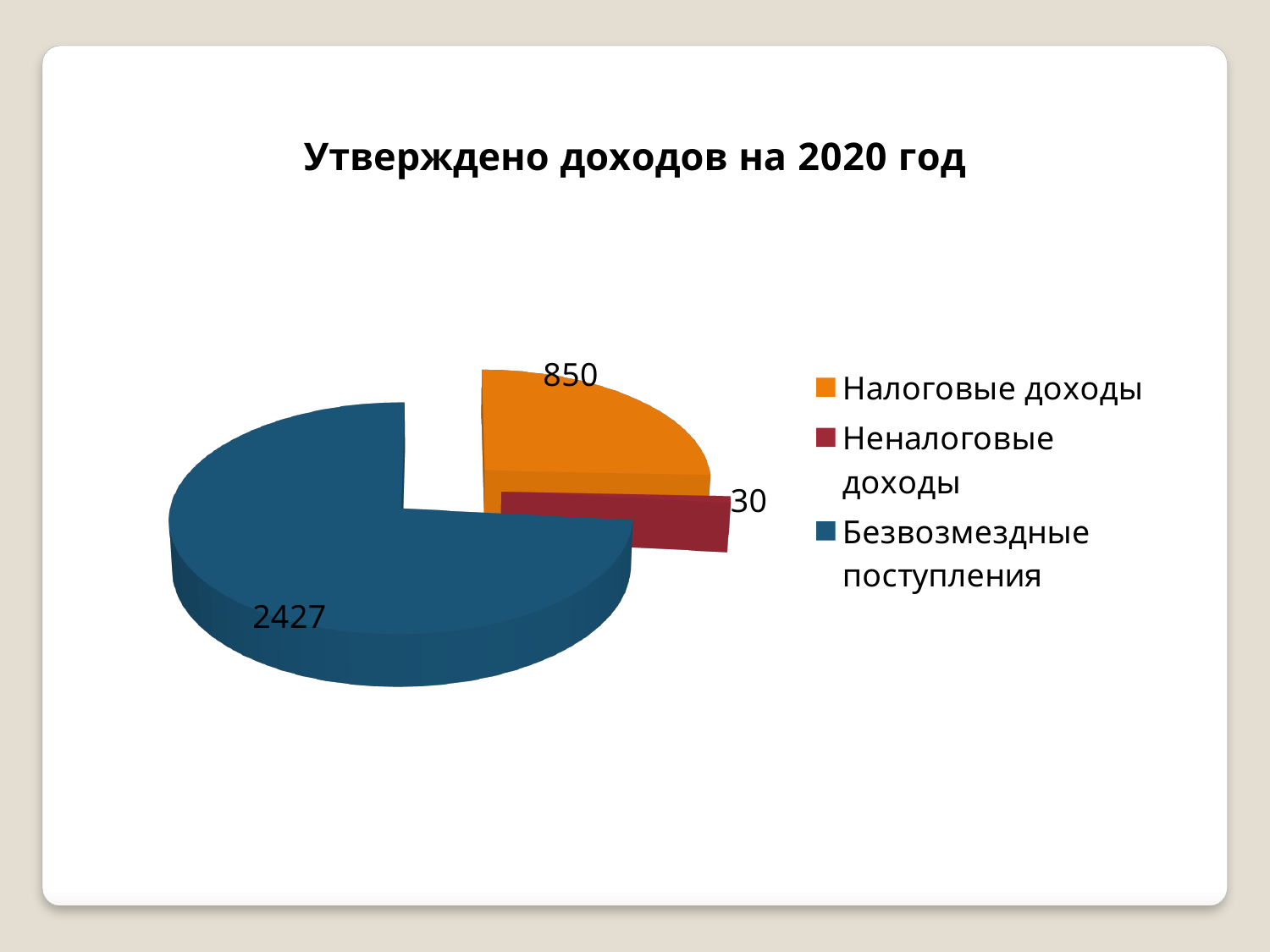
What is the difference between the values for Безвозмездные поступления and Налоговые доходы? 1577 What is the value for Неналоговые доходы? 30 Which category has the smallest slice of the pie? Неналоговые доходы Which category has the largest slice of the pie? Безвозмездные поступления What is the title of the chart? Утверждено доходов на 2020 год Which is larger, Налоговые доходы or Неналоговые доходы? Налоговые доходы What kind of chart is shown on the slide? Pie chart What is the difference between the values for Налоговые доходы and Неналоговые доходы? 820 What is the value for Налоговые доходы? 850 What is the total of all three slices? 3307 How many slices does the pie chart have? 3 What is the value for Безвозмездные поступления? 2427